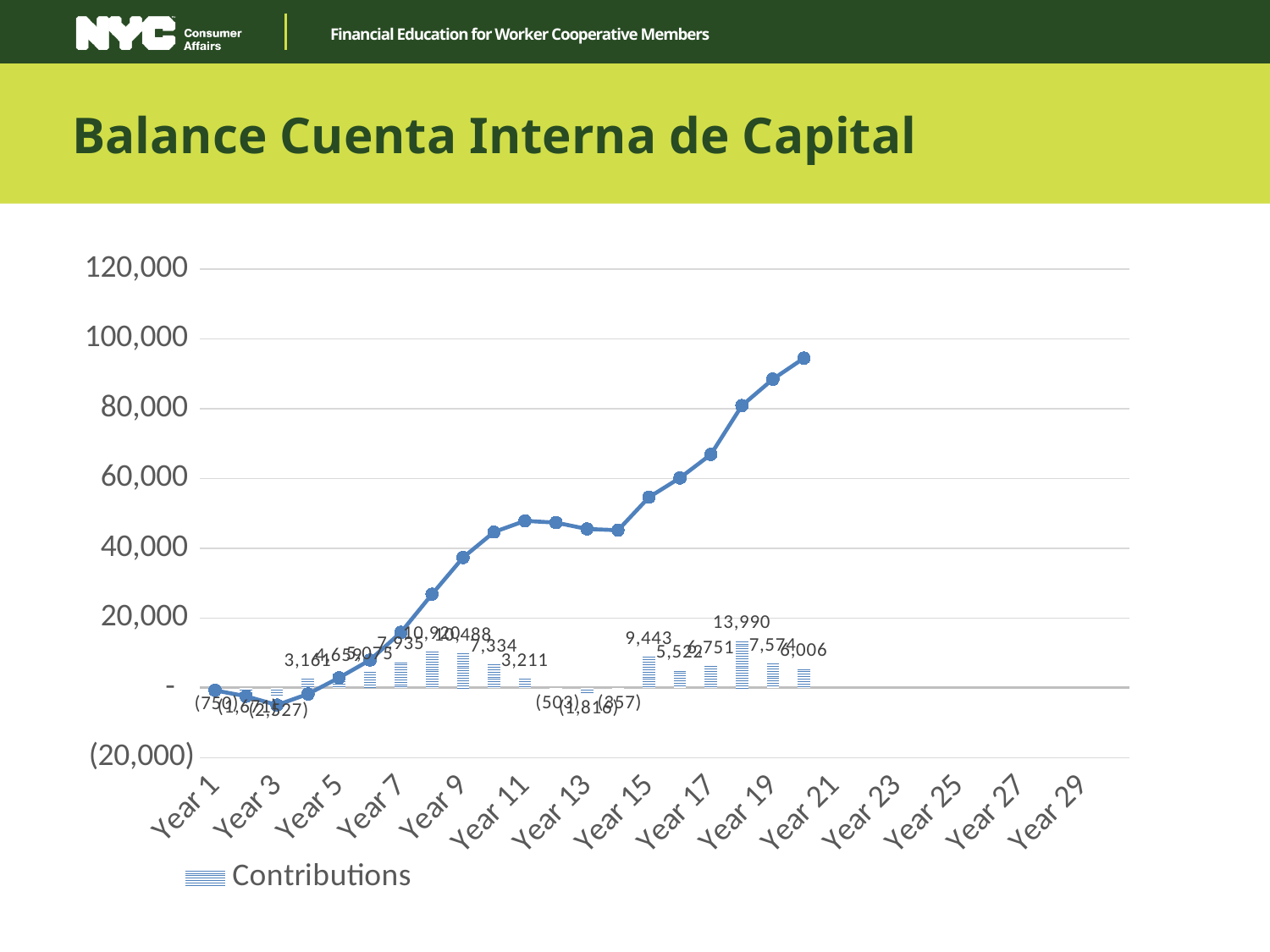
What is the Contributions value labeled for Year 1? (750) What is the difference between the Contributions labels 13,990 and 7,574? 6,416 How many series does the legend list? 1 What series name does the chart legend list? Contributions Is the value of the line at Year 20 greater or less than 80,000? greater Which Contributions label is larger, 9,443 or 5,522? 9,443 What is the title of the slide containing the chart? Balance Cuenta Interna de Capital How many data points are plotted on the line series? 20 What is the largest Contributions value labeled on the chart? 13,990 What is the lowest (most negative) Contributions value labeled on the chart? (2,527) What kind of chart is shown on the slide? A combined line and bar chart Does the line series generally rise or fall from Year 1 to Year 20? Rise